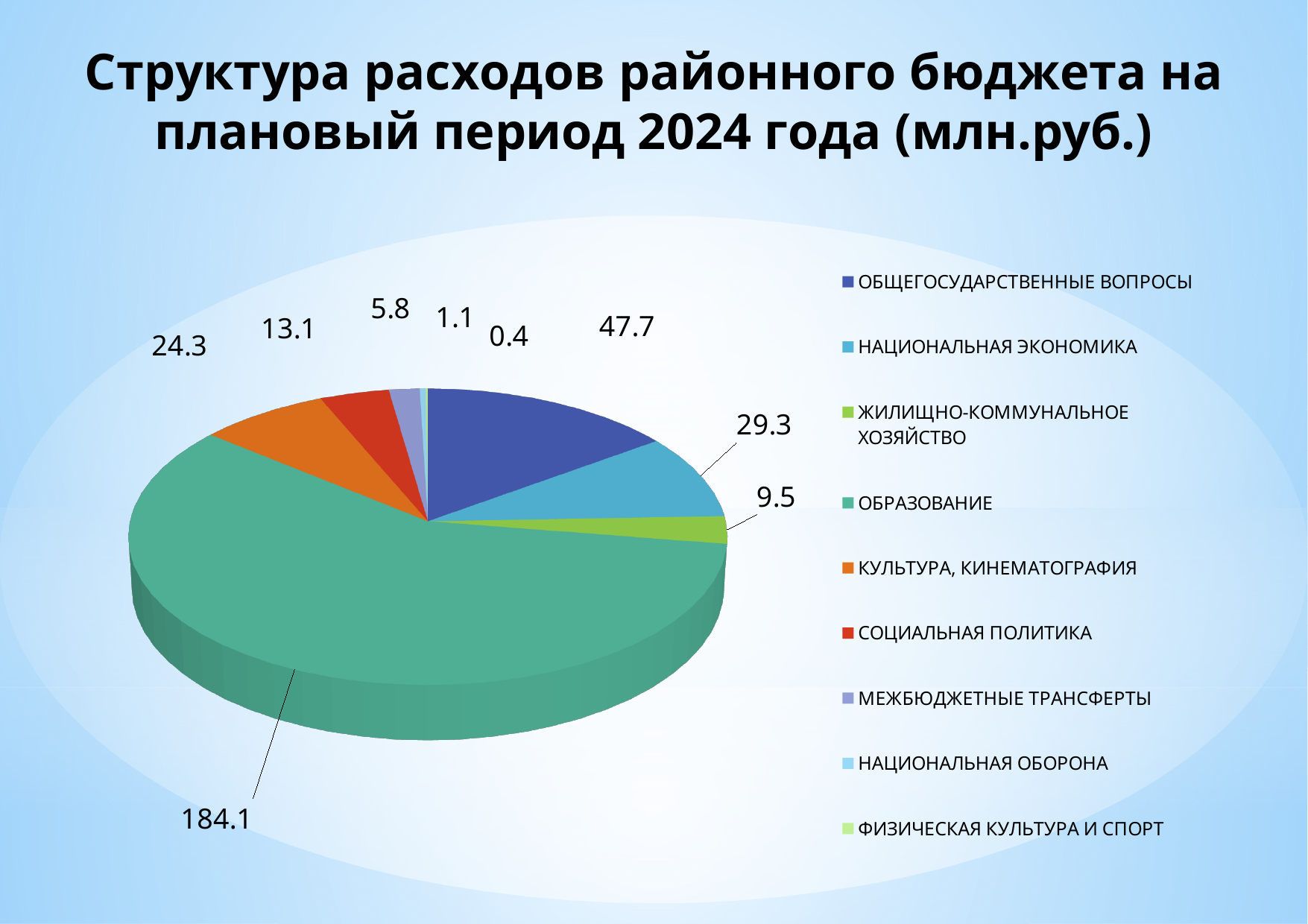
Which category has the largest slice of the pie? ОБРАЗОВАНИЕ What type of chart is shown on the slide? pie chart How many categories does the legend list? 9 Which is larger, the value for СОЦИАЛЬНАЯ ПОЛИТИКА or the value for ЖИЛИЩНО-КОММУНАЛЬНОЕ ХОЗЯЙСТВО? СОЦИАЛЬНАЯ ПОЛИТИКА What is the value for ОБРАЗОВАНИЕ? 184.1 What is the value for ФИЗИЧЕСКАЯ КУЛЬТУРА И СПОРТ? 0.4 What is the value for НАЦИОНАЛЬНАЯ ЭКОНОМИКА? 29.3 Which category has the smallest slice of the pie? ФИЗИЧЕСКАЯ КУЛЬТУРА И СПОРТ What is the value for ОБЩЕГОСУДАРСТВЕННЫЕ ВОПРОСЫ? 47.7 What is the difference between the values for ОБЩЕГОСУДАРСТВЕННЫЕ ВОПРОСЫ and НАЦИОНАЛЬНАЯ ЭКОНОМИКА? 18.4 What colour is the slice for КУЛЬТУРА, КИНЕМАТОГРАФИЯ? orange What is the value for КУЛЬТУРА, КИНЕМАТОГРАФИЯ? 24.3